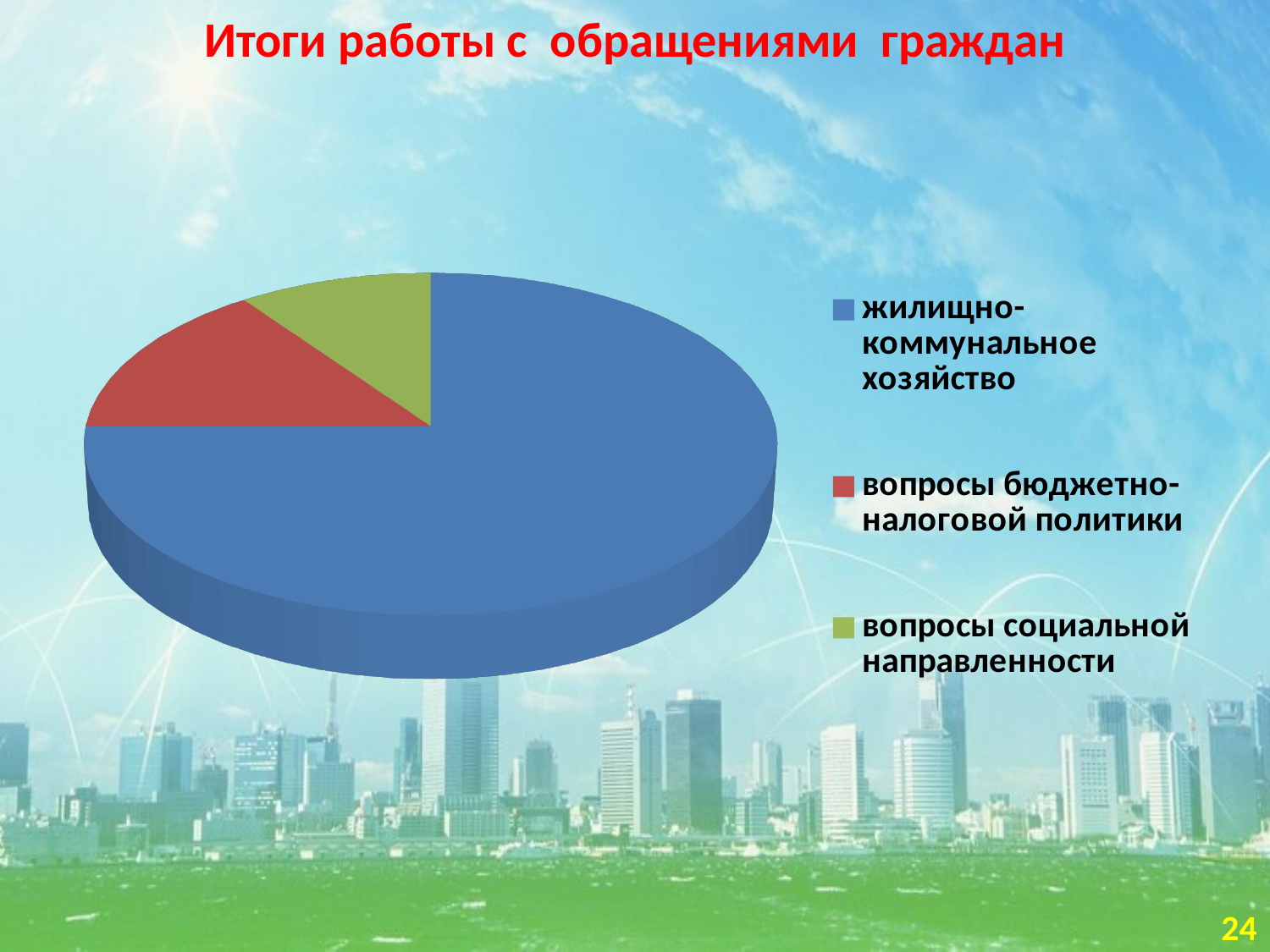
Which slice is larger: жилищно-коммунальное хозяйство or вопросы бюджетно-налоговой политики? жилищно-коммунальное хозяйство What kind of chart is shown on the slide? pie chart How many entries does the legend of the pie chart list? 3 What colour is the slice for вопросы бюджетно-налоговой политики in the pie chart? red How many slices does the pie chart have? 3 What is the title of the slide containing the pie chart? Итоги работы с обращениями граждан Which category has the largest slice of the pie chart? жилищно-коммунальное хозяйство Which category has the smallest slice of the pie chart? вопросы социальной направленности Which slice is larger: вопросы бюджетно-налоговой политики or вопросы социальной направленности? вопросы бюджетно-налоговой политики